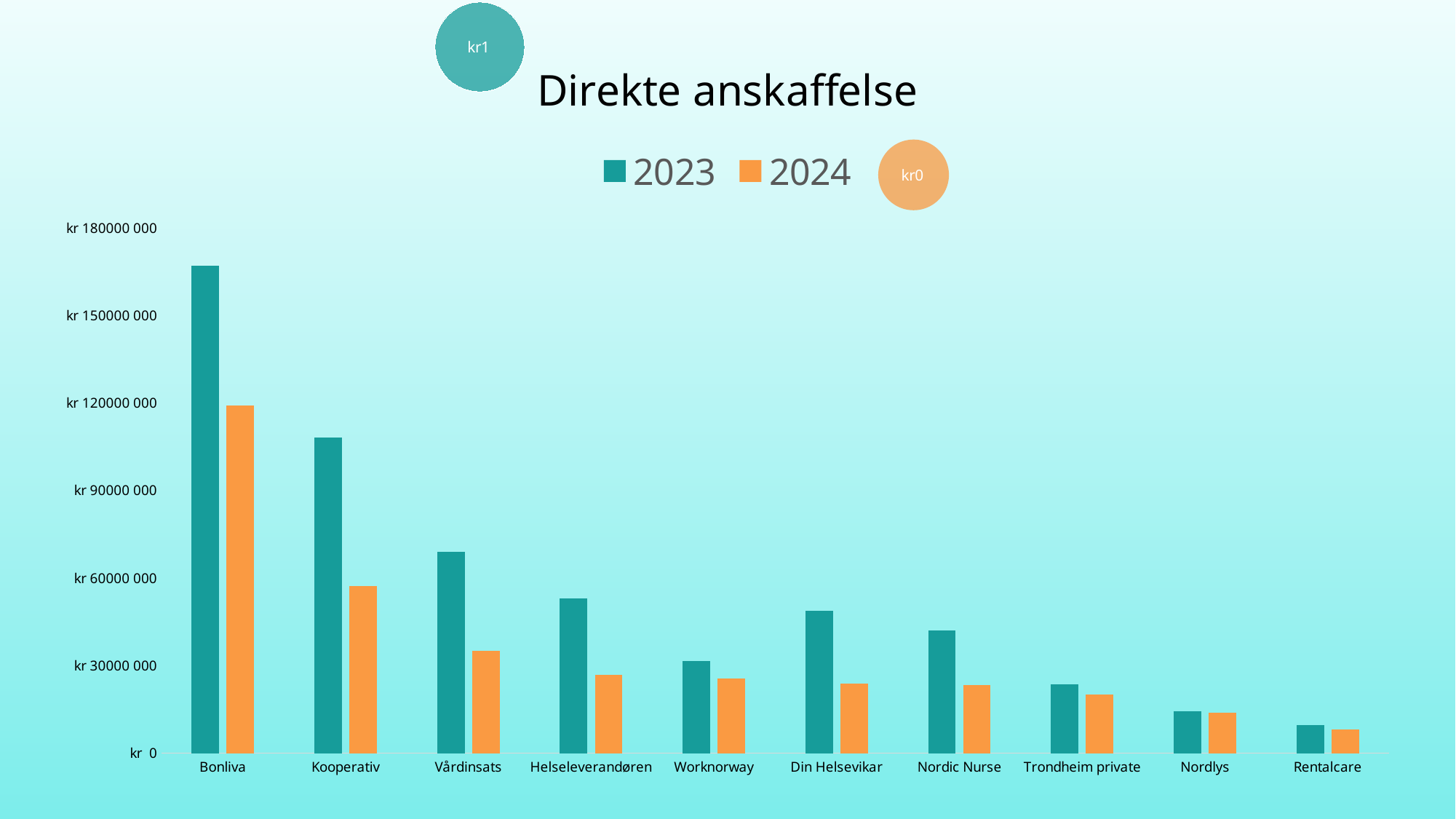
Is the 2023 value for Trondheim private greater or less than kr 30000 000? less Is the 2023 value for Helseleverandøren greater or less than kr 60000 000? less Is the 2023 value for Bonliva greater or less than kr 150000 000? greater Which category has the lowest value for 2024? Rentalcare Which is larger, the 2023 value for Worknorway or the 2023 value for Din Helsevikar? Din Helsevikar How many series does the legend list? 2 How many categories are shown on the x axis? 10 Which category has the highest value for 2023? Bonliva Do the 2023 values generally rise or fall from left to right along the x axis? fall What is the title of the chart? Direkte anskaffelse What kind of chart is shown on the slide? bar chart